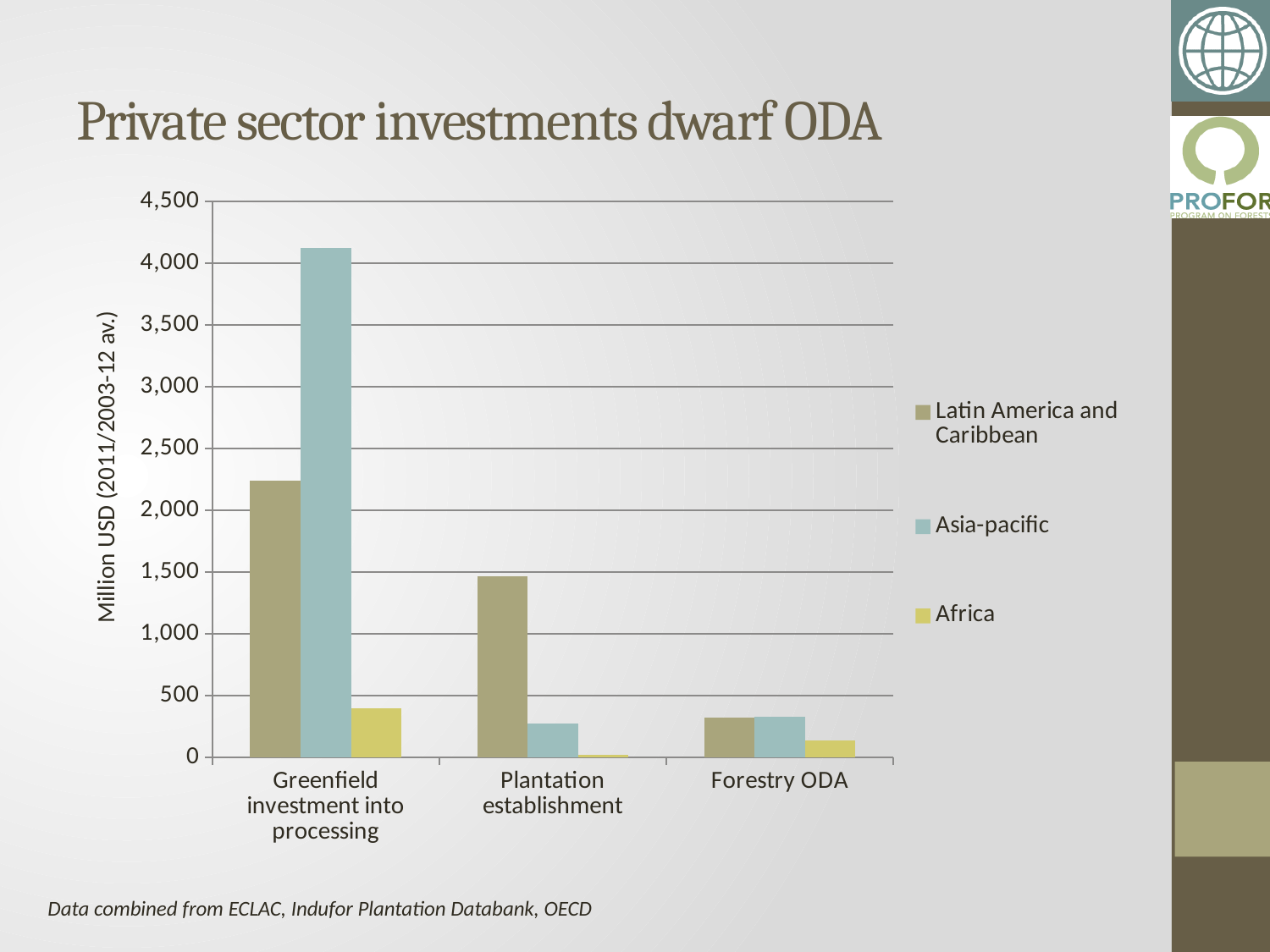
For Plantation establishment, which is larger: Latin America and Caribbean or Asia-pacific? Latin America and Caribbean How many series does the legend list? 3 Is the Latin America and Caribbean value for Greenfield investment into processing greater or less than 2,000? greater Do the Latin America and Caribbean values rise or fall from left to right across the categories? fall For Greenfield investment into processing, which is larger: Latin America and Caribbean or Asia-pacific? Asia-pacific For which category is the Africa value lowest? Plantation establishment Is the Latin America and Caribbean value for Plantation establishment greater or less than 1,000? greater For which category is the Asia-pacific value highest? Greenfield investment into processing How many categories are shown on the x axis? 3 What kind of chart is shown on the slide? bar chart Is the Asia-pacific value for Greenfield investment into processing greater or less than 4,000? greater